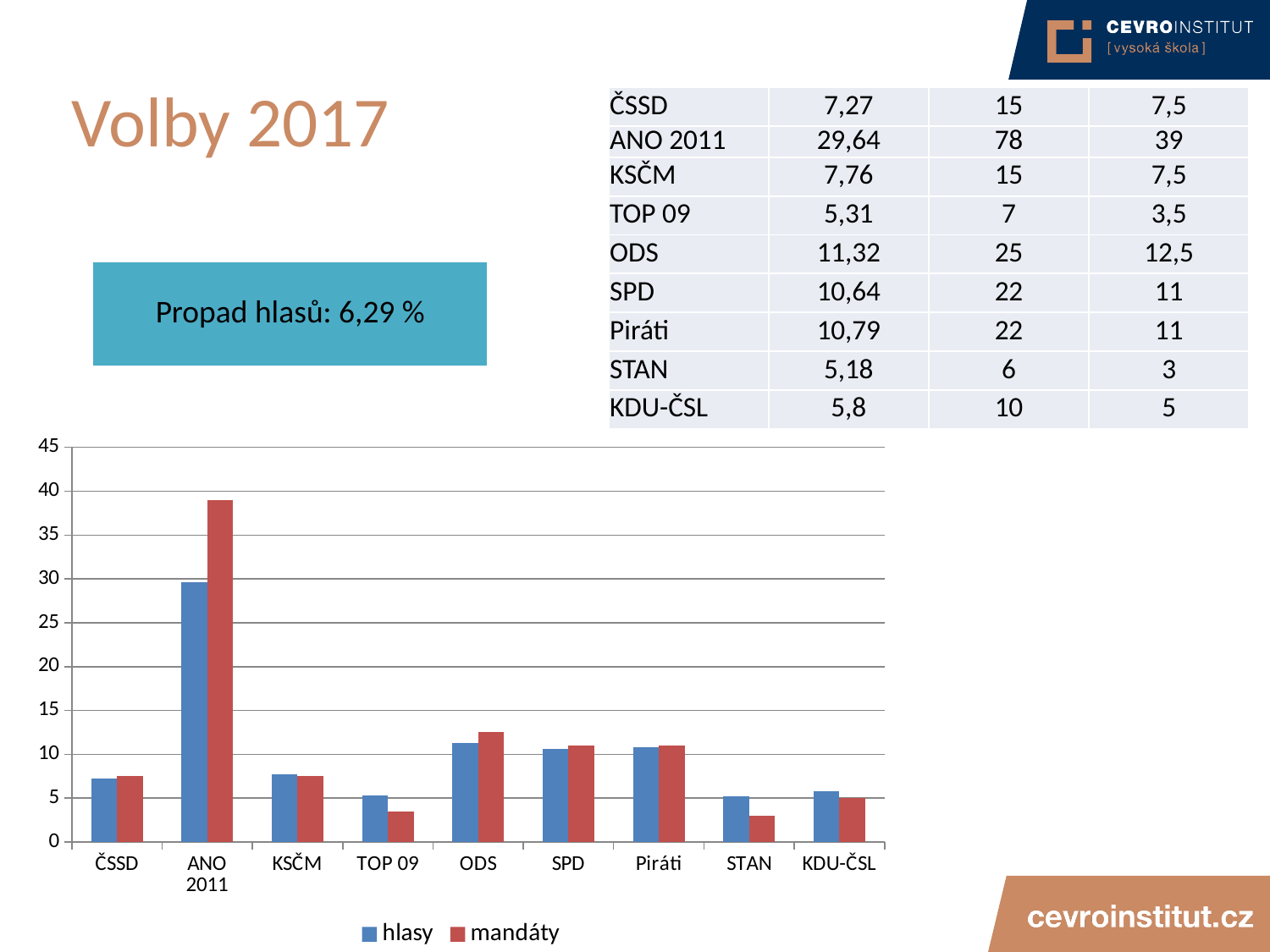
Is the mandáty value for ANO 2011 greater or less than 35? greater Is the mandáty value for TOP 09 greater or less than 5? less How many series does the chart legend list? 2 What kind of chart is shown on the slide? bar chart For ANO 2011, which is larger in the chart: hlasy or mandáty? mandáty What are the two legend entries of the chart? hlasy, mandáty How many parties are shown on the x axis of the chart? 9 Which party has the lowest value for mandáty in the chart? STAN For STAN, which is larger in the chart: hlasy or mandáty? hlasy Is the hlasy value for ODS greater or less than 10? greater Which party has the highest value for hlasy in the chart? ANO 2011 What colour are the mandáty bars in the chart? red